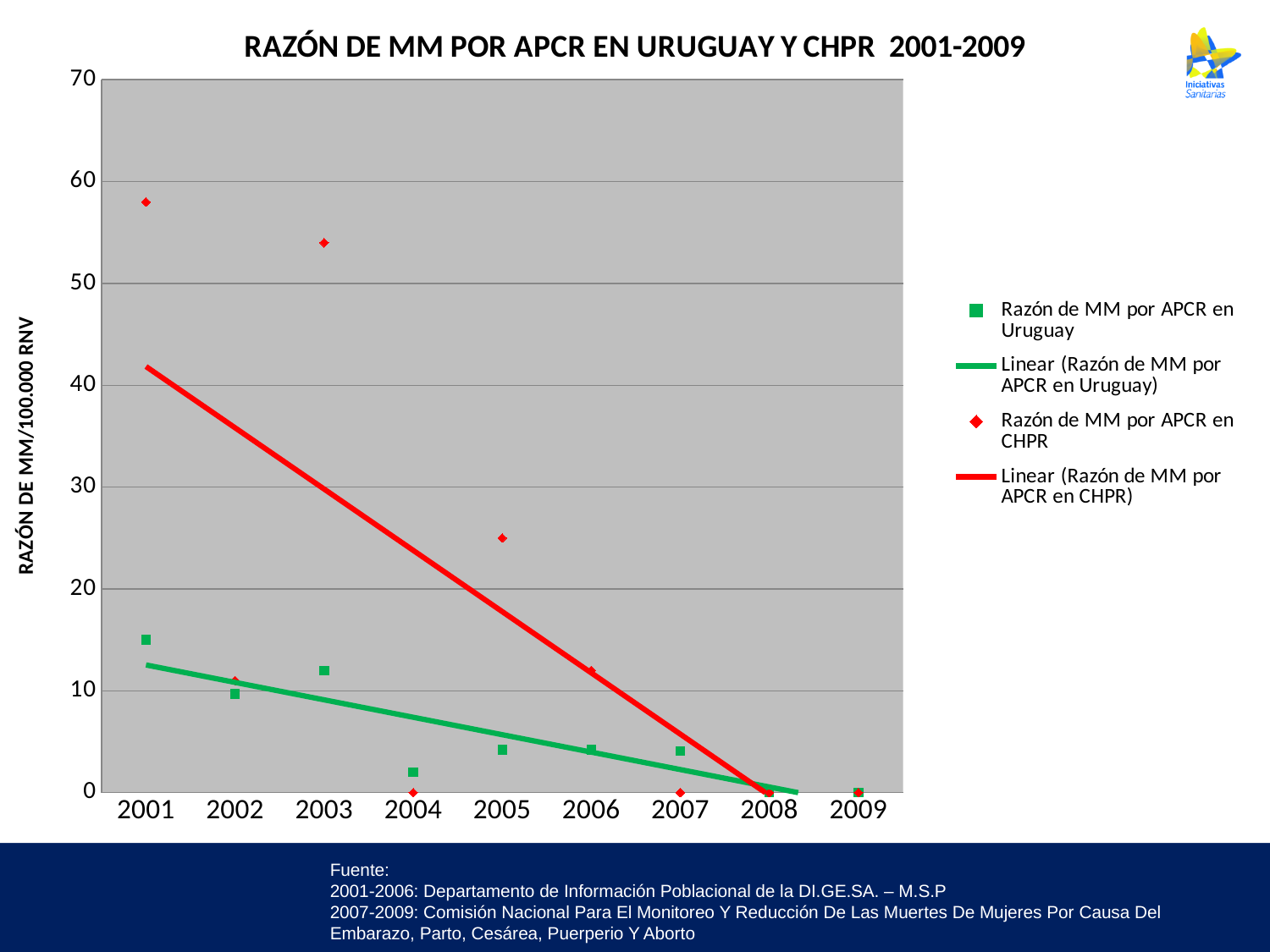
Is the value for Razón de MM por APCR en Uruguay in 2001 greater or less than 10? greater Is the value for Razón de MM por APCR en CHPR in 2005 greater or less than 30? less Which is larger in 2003, the value for Razón de MM por APCR en CHPR or the value for Razón de MM por APCR en Uruguay? Razón de MM por APCR en CHPR In which year is the value for Razón de MM por APCR en CHPR highest? 2001 What kind of chart is shown on the slide? Scatter chart How many years are shown on the x axis? 9 Do the trend lines for both series rise or fall from 2001 to 2009? Fall How many entries does the legend list? 4 Is the value for Razón de MM por APCR en CHPR in 2001 greater or less than 50? greater In which year is the value for Razón de MM por APCR en Uruguay highest? 2001 What is the title of the chart? RAZÓN DE MM POR APCR EN URUGUAY Y CHPR 2001-2009 What is the label of the vertical axis? RAZÓN DE MM/100.000 RNV